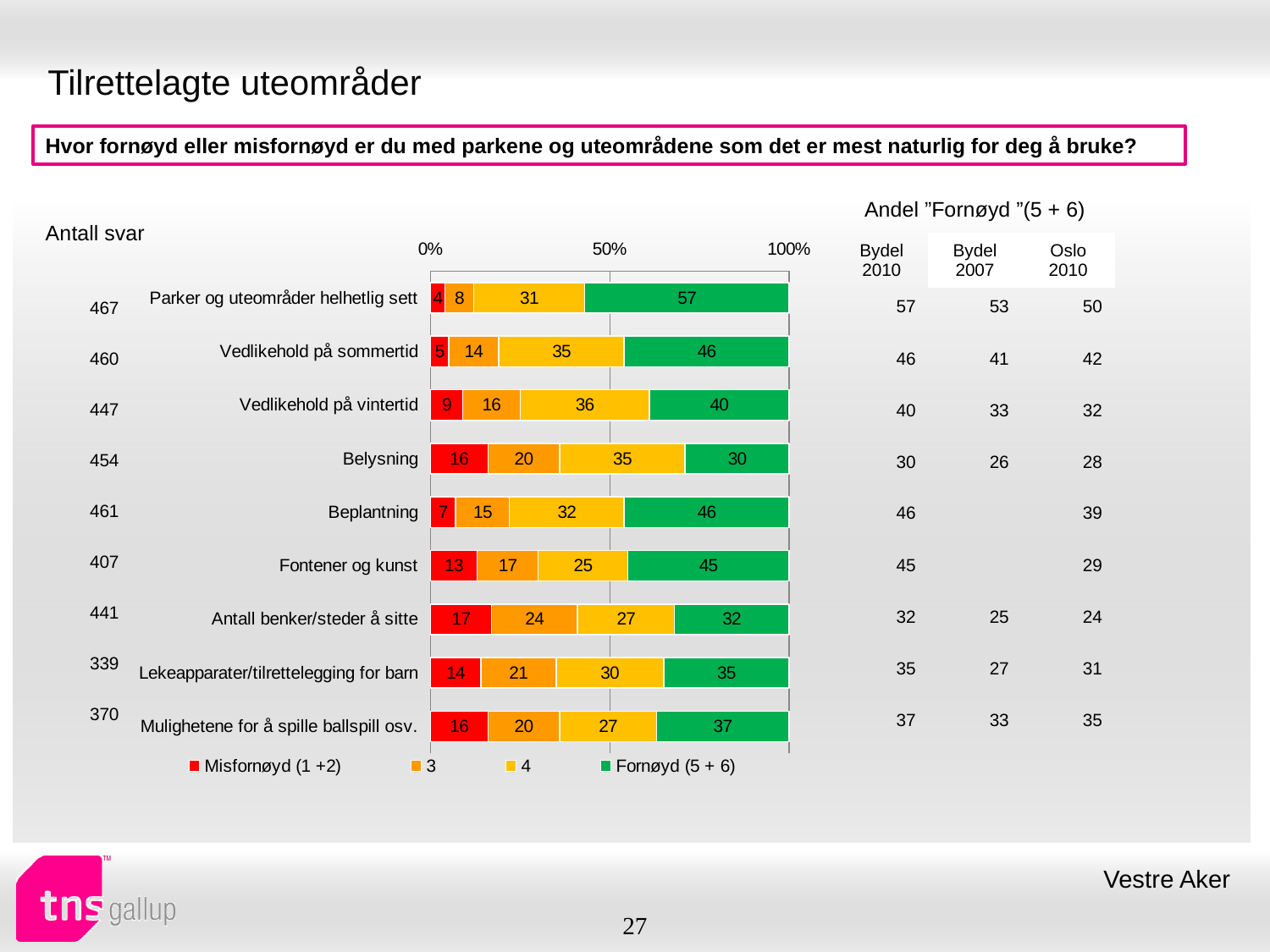
What is the value of "Fornøyd (5 + 6)" for "Parker og uteområder helhetlig sett"? 57 What kind of chart is shown on the slide? Stacked bar chart What is the difference between the "Fornøyd (5 + 6)" values for "Parker og uteområder helhetlig sett" and "Belysning"? 27 What is the value of series "3" for "Antall benker/steder å sitte"? 24 How many series does the chart legend list? 4 What is the total of the stacked bar for "Mulighetene for å spille ballspill osv."? 100 What is the value of "Misfornøyd (1 +2)" for "Belysning"? 16 Which category has the highest "Fornøyd (5 + 6)" value? Parker og uteområder helhetlig sett What is the value of series "4" for "Vedlikehold på vintertid"? 36 Which category has the lowest "Fornøyd (5 + 6)" value? Belysning Which has a larger "Fornøyd (5 + 6)" value, "Vedlikehold på sommertid" or "Vedlikehold på vintertid"? Vedlikehold på sommertid How many categories are plotted in the chart? 9